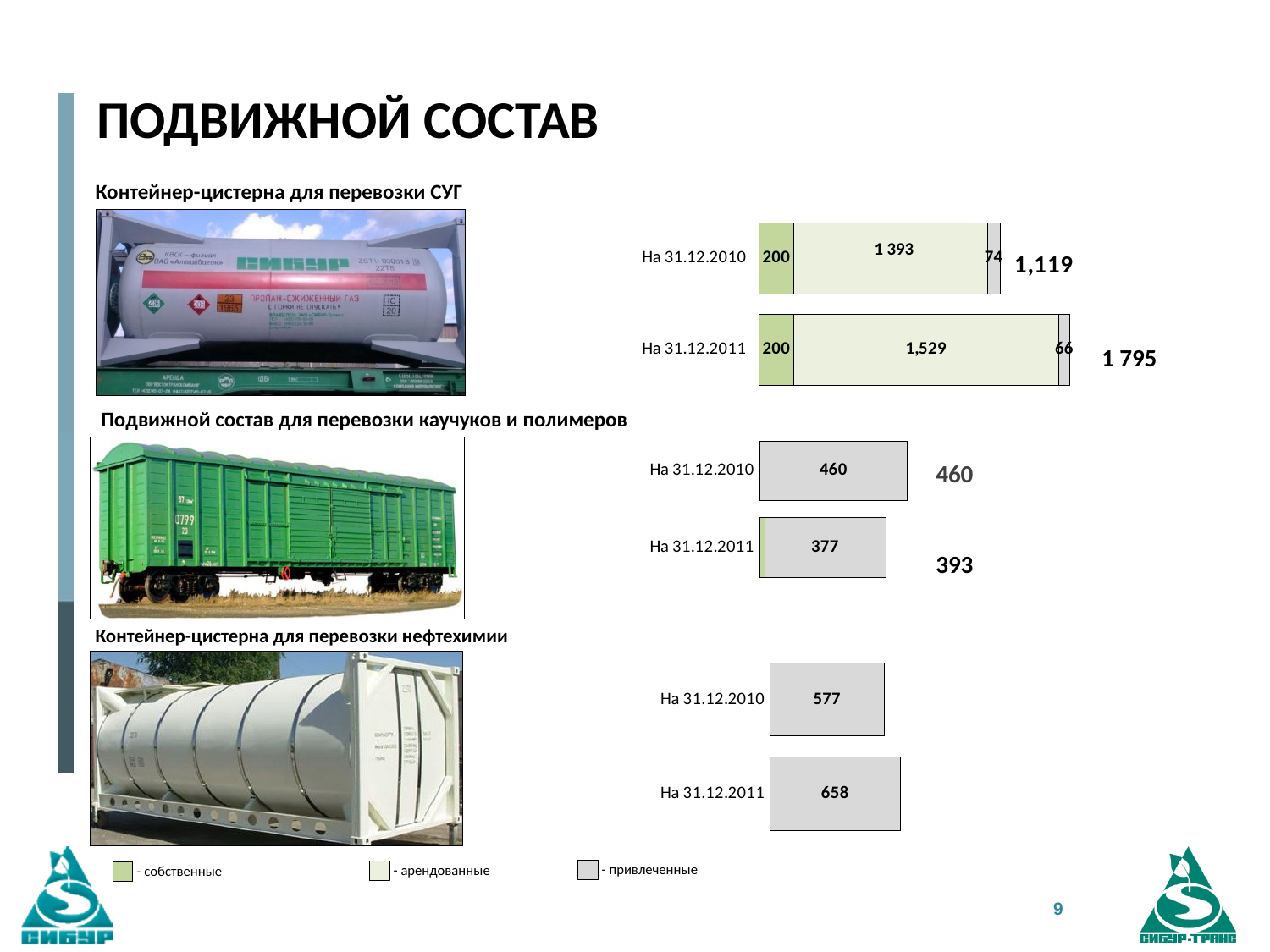
In the chart for Подвижной состав для перевозки каучуков и полимеров, what is the value of the привлеченные segment for На 31.12.2011? 377 In the chart for Контейнер-цистерна для перевозки нефтехимии, what is the difference between the values for На 31.12.2011 and На 31.12.2010? 81 In the chart for Контейнер-цистерна для перевозки нефтехимии, which date has the larger value, На 31.12.2010 or На 31.12.2011? На 31.12.2011 In the chart for Контейнер-цистерна для перевозки СУГ, what is the total shown for На 31.12.2011? 1 795 How many categories (dates) does the chart for Контейнер-цистерна для перевозки СУГ show? 2 What kind of chart is used for Контейнер-цистерна для перевозки СУГ? Stacked bar chart In the chart for Контейнер-цистерна для перевозки нефтехимии, what is the value for На 31.12.2011? 658 In the chart for Контейнер-цистерна для перевозки СУГ, what is the value of the привлеченные segment for На 31.12.2011? 66 In the chart for Подвижной состав для перевозки каучуков и полимеров, what total is shown for На 31.12.2011? 393 In the chart for Подвижной состав для перевозки каучуков и полимеров, which date has the higher total? На 31.12.2010 In the chart for Контейнер-цистерна для перевозки СУГ, what is the value of the собственные segment for На 31.12.2010? 200 In the chart for Контейнер-цистерна для перевозки СУГ, what is the value of the арендованные segment for На 31.12.2011? 1,529